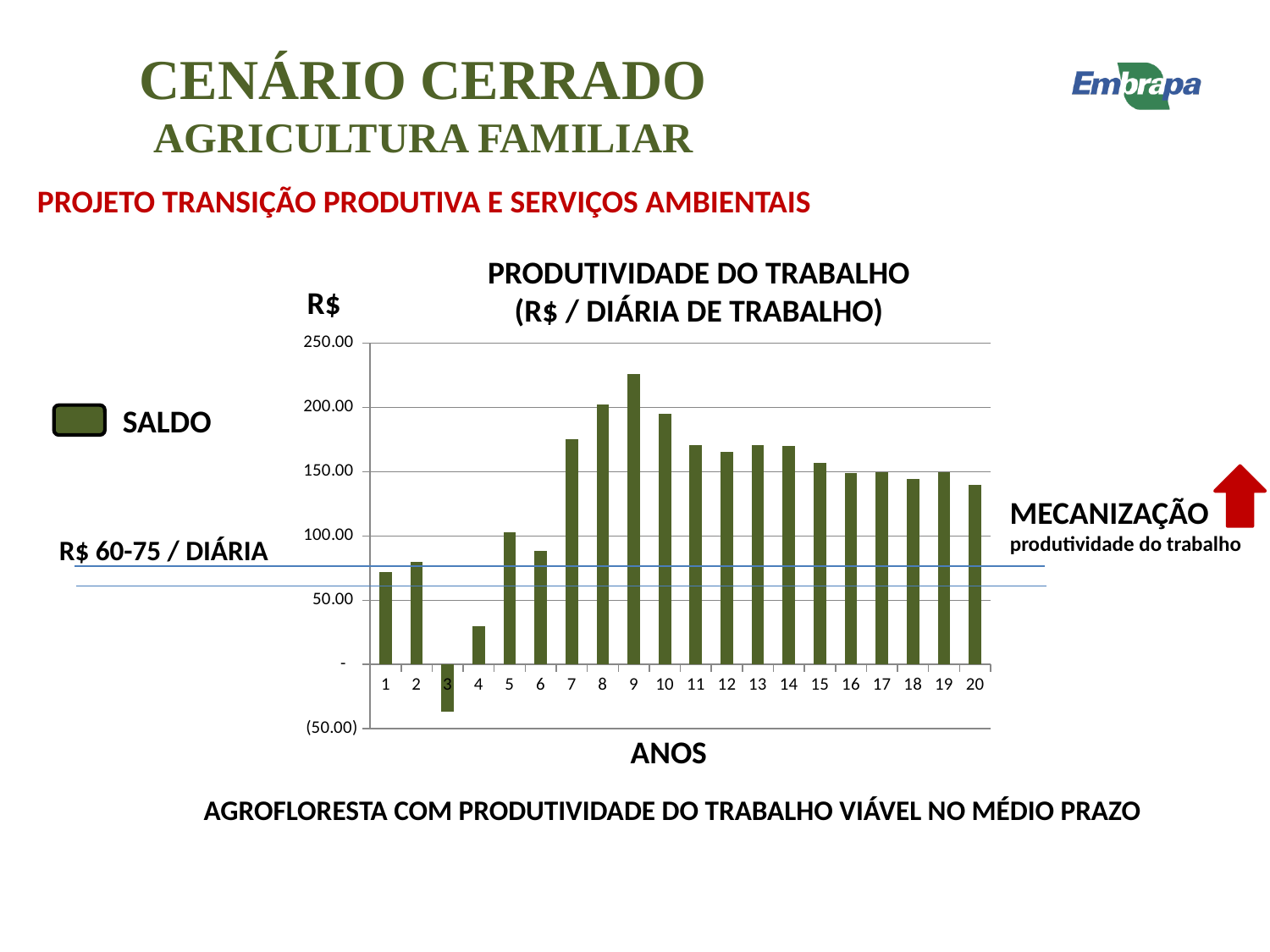
Is the value for year 7 greater or less than 150? greater Which year has the lowest value in the chart? 3 What kind of chart is shown on the slide? bar chart How many years (categories) are plotted on the x axis of the chart? 20 Do the values rise or fall from year 9 to year 20? fall Which is larger, the value for year 7 or the value for year 2? year 7 What is the label of the series shown in the chart legend? SALDO Is the value for year 4 greater or less than 50? less Is the value for year 20 greater or less than 150? less Which year has the highest value in the chart? 9 How many series does the legend of the chart list? 1